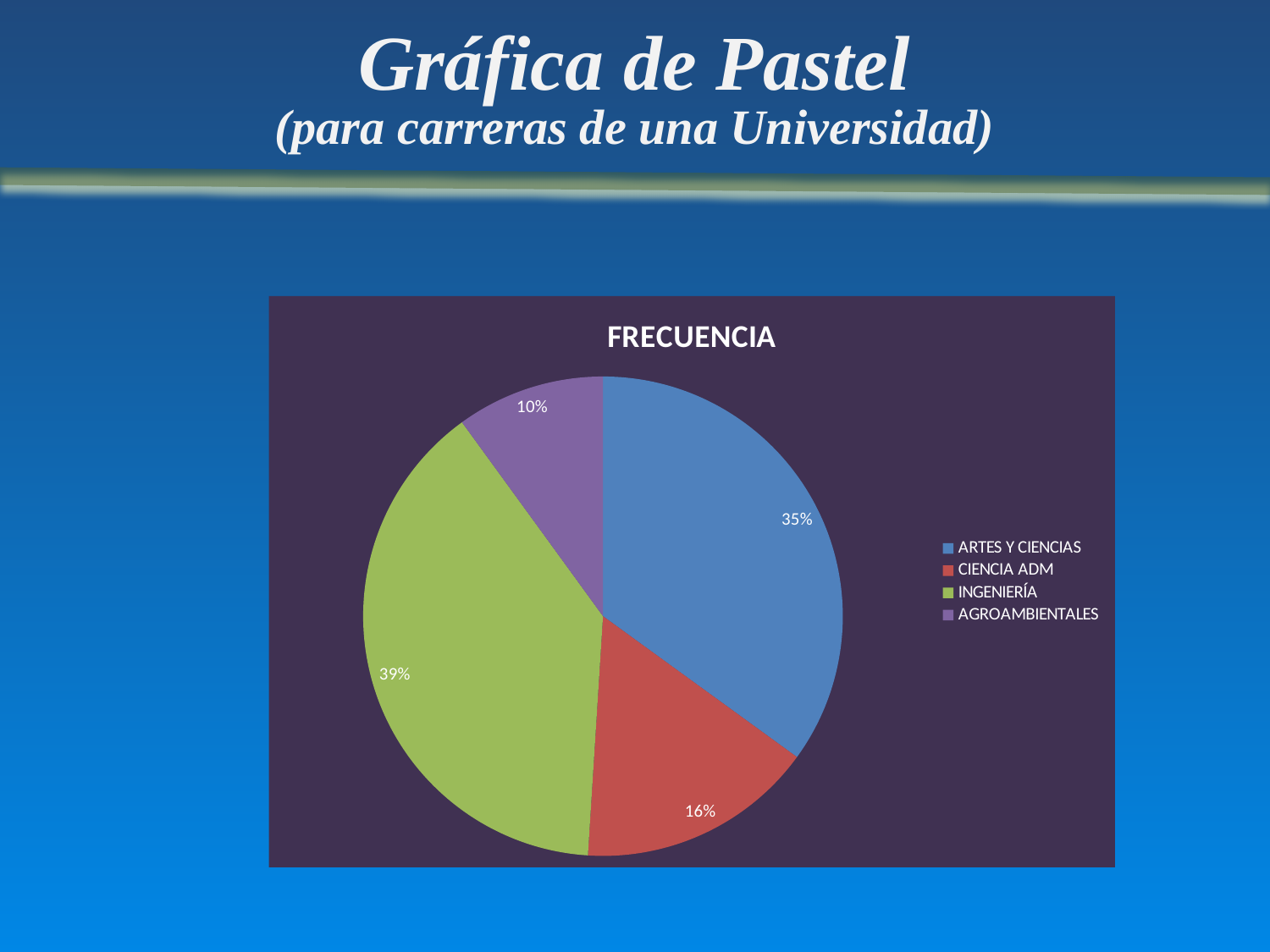
What percentage share does CIENCIA ADM have? 16% What is the title of the chart? FRECUENCIA Which category has the smallest slice of the pie? AGROAMBIENTALES What percentage share does ARTES Y CIENCIAS have? 35% Which is larger, the share for ARTES Y CIENCIAS or the share for CIENCIA ADM? ARTES Y CIENCIAS What percentage share does INGENIERÍA have? 39% Which colour represents INGENIERÍA in the legend? green What type of chart is shown on the slide? pie chart What percentage share does AGROAMBIENTALES have? 10% How many categories does the pie chart show? 4 Which category has the largest slice of the pie? INGENIERÍA What is the difference in percentage points between INGENIERÍA and CIENCIA ADM? 23